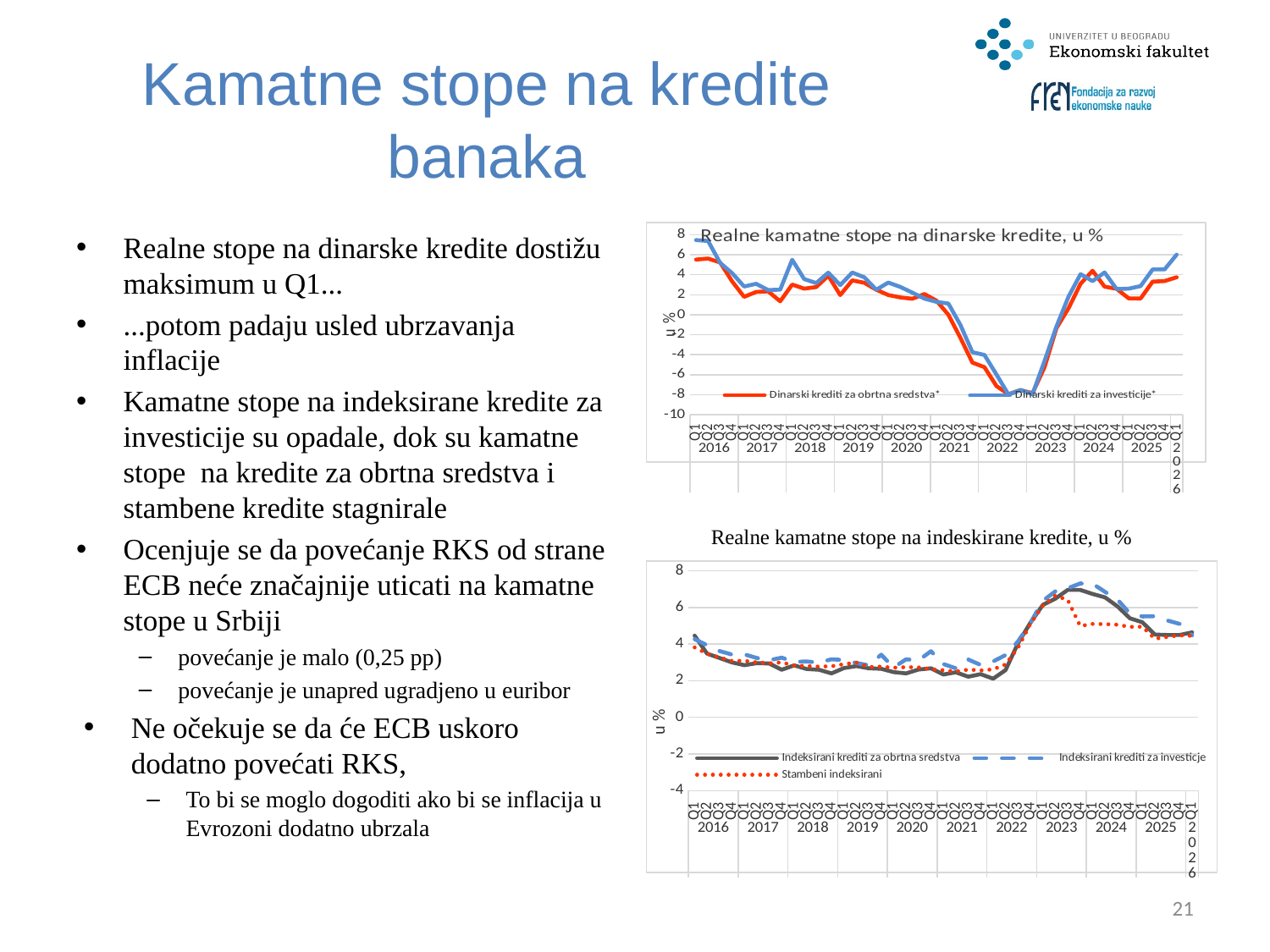
In the bottom chart, 'Realne kamatne stope na indeskirane kredite, u %', which series is drawn with a dotted red line? Stambeni indeksirani In the top chart, 'Realne kamatne stope na dinarske kredite, u %', is the value for Dinarski krediti za investicije* in 2016 Q1 greater or less than 6? greater How many series does the legend of the top chart, 'Realne kamatne stope na dinarske kredite, u %', list? 2 In the top chart, 'Realne kamatne stope na dinarske kredite, u %', do the values for Dinarski krediti za investicije* rise or fall from 2021 Q1 to 2022 Q3? fall In the bottom chart, 'Realne kamatne stope na indeskirane kredite, u %', is the value for Stambeni indeksirani in 2024 Q2 greater or less than 6? less In the top chart, 'Realne kamatne stope na dinarske kredite, u %', do the values for Dinarski krediti za obrtna sredstva* rise or fall from 2022 Q4 to 2024 Q1? rise In the top chart, 'Realne kamatne stope na dinarske kredite, u %', is the value for Dinarski krediti za obrtna sredstva* in 2016 Q1 greater or less than 6? less What kind of chart is the bottom chart, 'Realne kamatne stope na indeskirane kredite, u %'? line chart In the bottom chart, 'Realne kamatne stope na indeskirane kredite, u %', do the values for Indeksirani krediti za investicije rise or fall from 2022 Q1 to 2023 Q4? rise What kind of chart is the top chart, 'Realne kamatne stope na dinarske kredite, u %'? line chart How many series does the legend of the bottom chart, 'Realne kamatne stope na indeskirane kredite, u %', list? 3